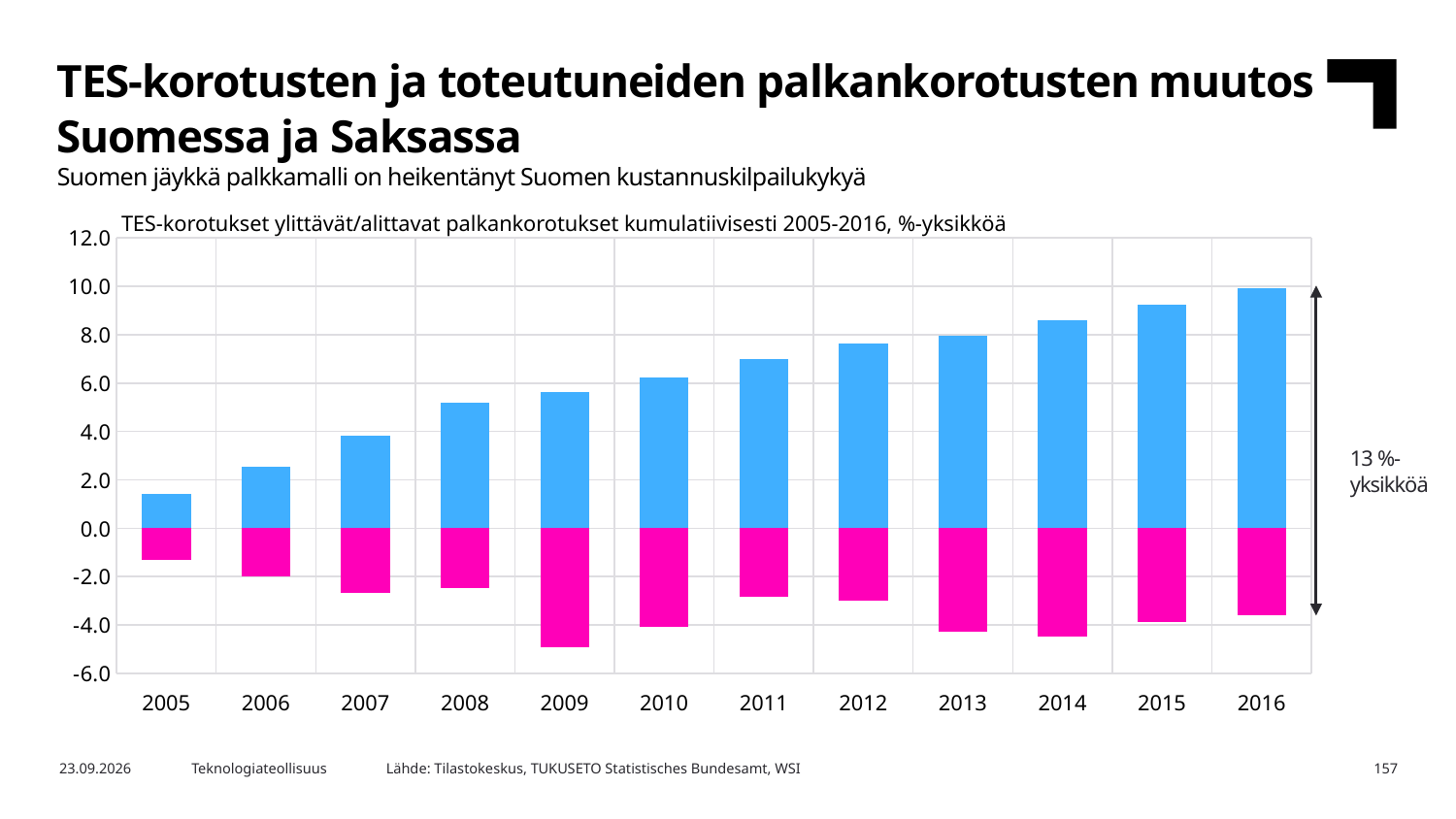
Which year has the shortest blue (positive) bar? 2005 Is the magenta bar for 2009 greater or less than -4.0? less Is the blue bar for 2005 greater or less than 2.0? less Which year has the larger blue bar, 2008 or 2012? 2012 Which year has the least negative magenta bar? 2005 What value does the annotation with the double-headed arrow to the right of the chart state? 13 %-yksikköä Which year has the most negative magenta bar? 2009 How many years are shown on the x axis of the chart? 12 What kind of chart is shown on the slide? bar chart Is the blue bar for 2016 greater or less than 8.0? greater Do the blue bars rise or fall from 2005 to 2016? rise Which year has the tallest blue (positive) bar? 2016